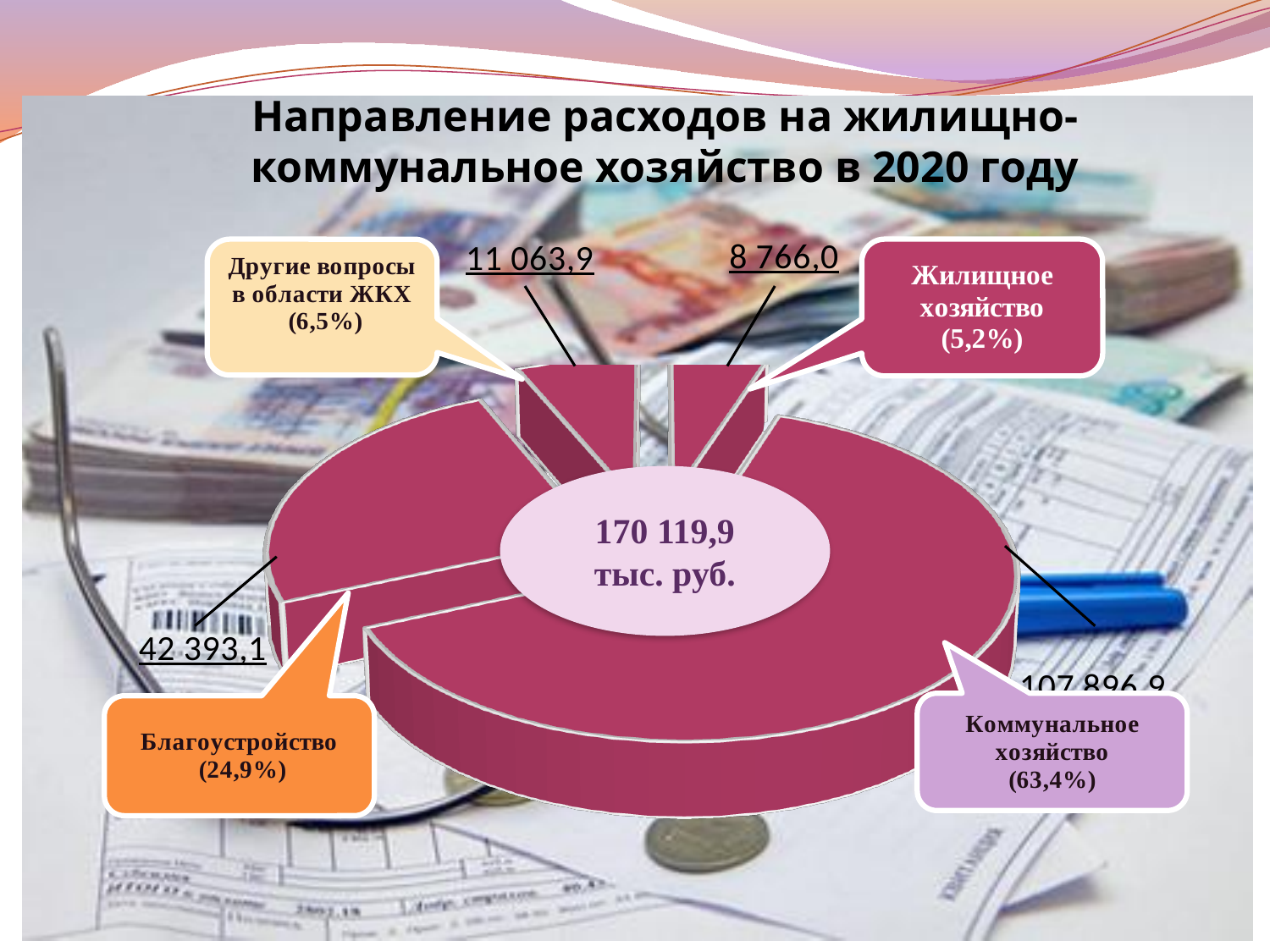
What is the value shown for Другие вопросы в области ЖКХ? 11 063,9 Which category has the smallest slice of the pie? Жилищное хозяйство Which category has the largest slice of the pie? Коммунальное хозяйство How many slices does the pie chart have? 4 What kind of chart is shown on the slide? pie chart What is the value shown for Жилищное хозяйство? 8 766,0 What share of the pie does Благоустройство take? 24,9% What total amount is shown in the centre of the pie chart? 170 119,9 тыс. руб. Which is larger, the value for Другие вопросы в области ЖКХ or the value for Жилищное хозяйство? Другие вопросы в области ЖКХ What share of the pie does Коммунальное хозяйство take? 63,4% What is the difference between the values for Другие вопросы в области ЖКХ and Жилищное хозяйство? 2 297,9 What is the value shown for Благоустройство? 42 393,1